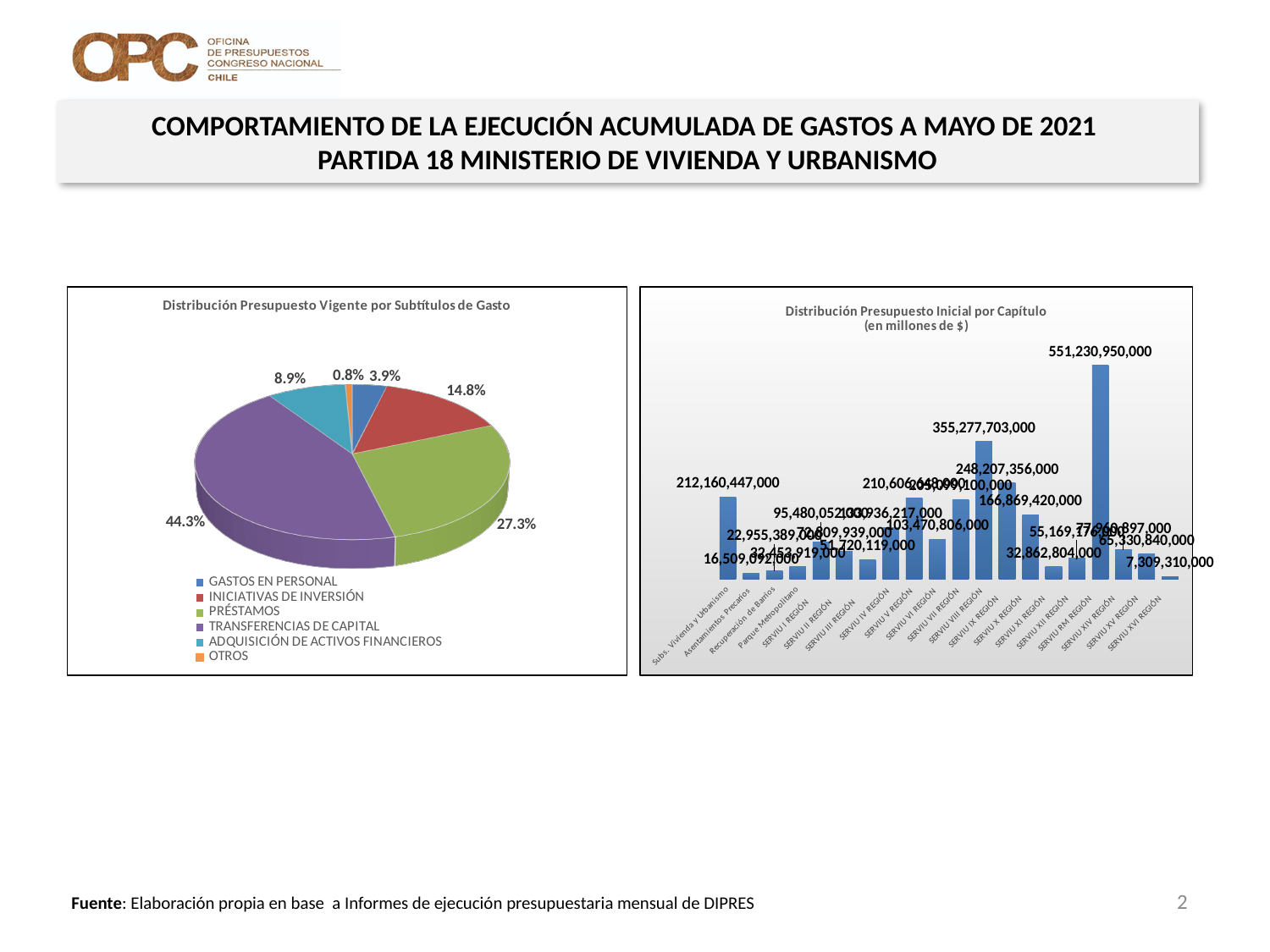
On the pie chart 'Distribución Presupuesto Vigente por Subtítulos de Gasto', what share does PRÉSTAMOS have? 27.3% On the bar chart 'Distribución Presupuesto Inicial por Capítulo', what is the value for SERVIU IX REGIÓN? 248,207,356,000 On the bar chart 'Distribución Presupuesto Inicial por Capítulo', which capítulo has the lowest value? SERVIU XVI REGIÓN On the bar chart 'Distribución Presupuesto Inicial por Capítulo', what is the value for SERVIU RM REGIÓN? 551,230,950,000 On the pie chart 'Distribución Presupuesto Vigente por Subtítulos de Gasto', what share does TRANSFERENCIAS DE CAPITAL have? 44.3% On the pie chart 'Distribución Presupuesto Vigente por Subtítulos de Gasto', which is larger: INICIATIVAS DE INVERSIÓN or ADQUISICIÓN DE ACTIVOS FINANCIEROS? INICIATIVAS DE INVERSIÓN What kind of chart is 'Distribución Presupuesto Inicial por Capítulo'? Bar chart On the pie chart 'Distribución Presupuesto Vigente por Subtítulos de Gasto', which category has the smallest share? OTROS On the pie chart 'Distribución Presupuesto Vigente por Subtítulos de Gasto', what is the difference in percentage points between TRANSFERENCIAS DE CAPITAL and PRÉSTAMOS? 17.0 On the bar chart 'Distribución Presupuesto Inicial por Capítulo', which capítulo has the highest value? SERVIU RM REGIÓN How many categories does the legend of the pie chart 'Distribución Presupuesto Vigente por Subtítulos de Gasto' list? 6 On the pie chart 'Distribución Presupuesto Vigente por Subtítulos de Gasto', which category has the largest share? TRANSFERENCIAS DE CAPITAL